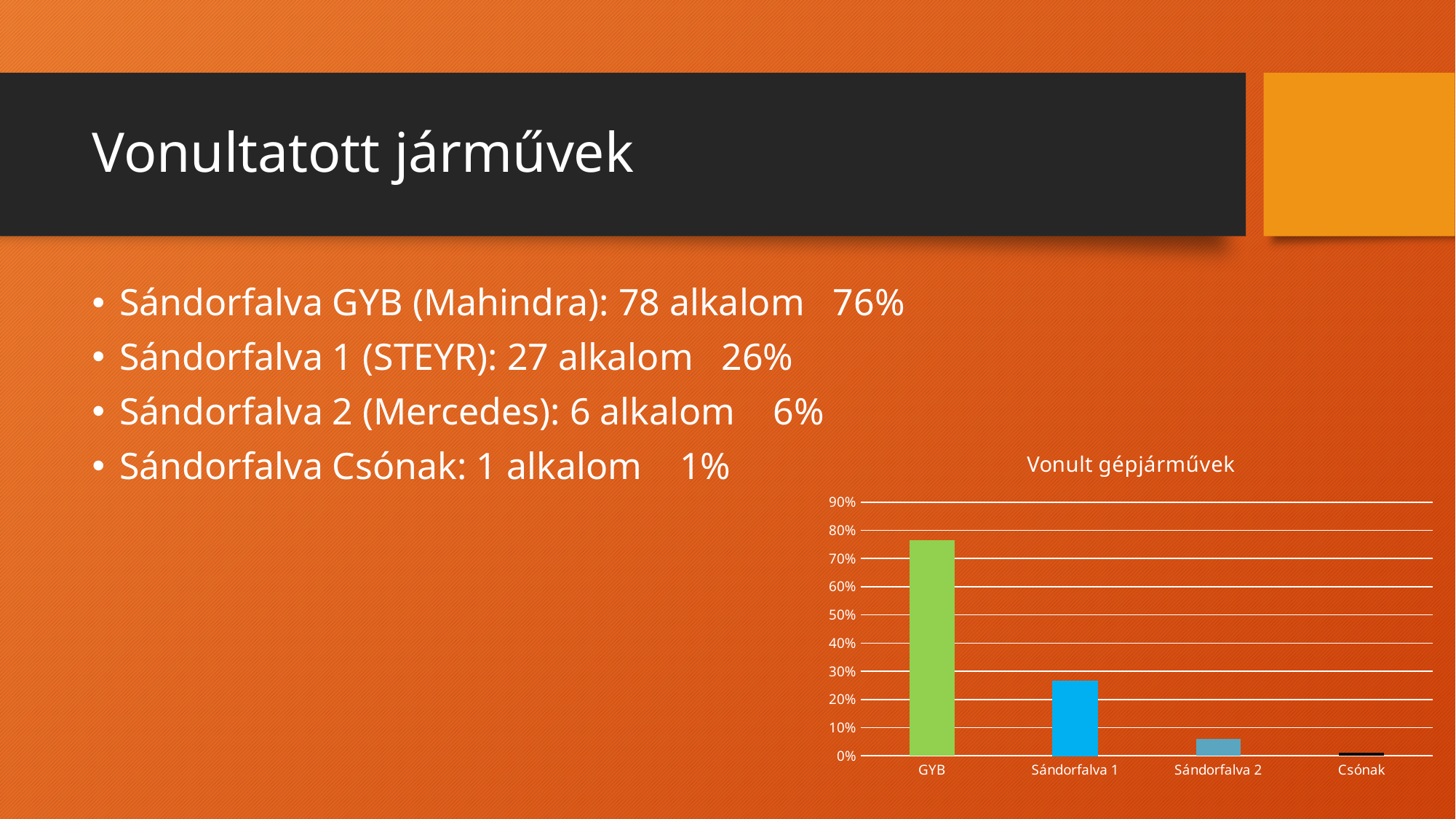
Do the bar values rise or fall from left to right along the x axis? fall What is the highest value shown on the chart's vertical axis? 90% Is the value for GYB greater or less than 70%? greater According to the slide, what percentage does GYB (Mahindra) account for? 76% What kind of chart is shown on the slide? bar chart Which is larger, the value for Sándorfalva 1 or the value for Sándorfalva 2? Sándorfalva 1 Is the value for Sándorfalva 2 greater or less than 10%? less Is the value for Sándorfalva 1 greater or less than 30%? less Which category has the highest bar in the chart? GYB Which category has the lowest bar in the chart? Csónak How many categories are shown on the x axis of the chart? 4 What is the title of the chart? Vonult gépjárművek